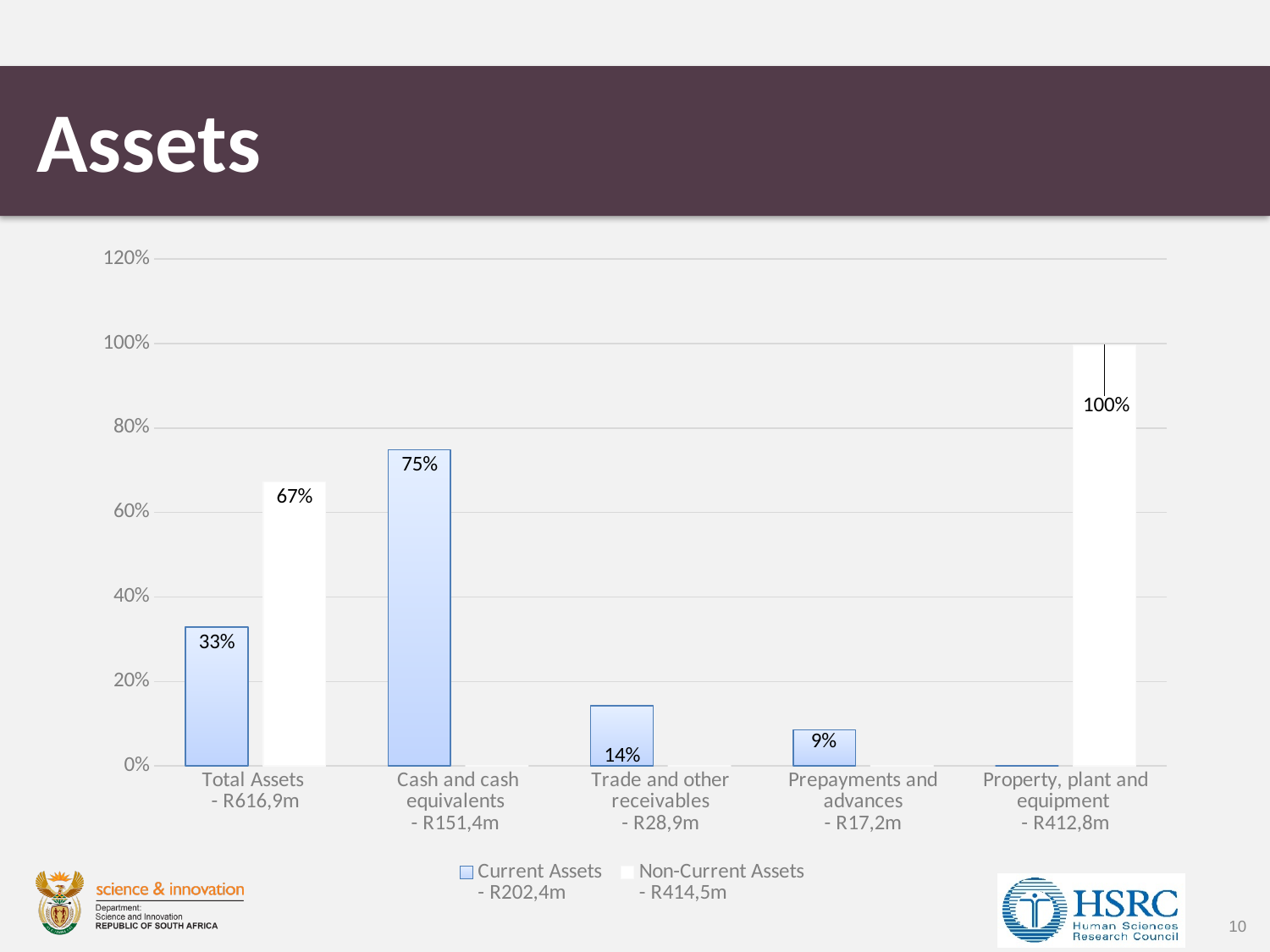
What is the Current Assets value for Total Assets? 33% How many series does the legend list? 2 What is the Current Assets value for Trade and other receivables? 14% What is the Non-Current Assets value for Total Assets? 67% What is the Current Assets value for Cash and cash equivalents? 75% Which category has the lowest labelled Current Assets value? Prepayments and advances Which category has the highest Current Assets value? Cash and cash equivalents What is the Non-Current Assets value for Property, plant and equipment? 100% Which is larger for Total Assets: the Current Assets value or the Non-Current Assets value? Non-Current Assets What is the difference between the Current Assets values for Cash and cash equivalents and Trade and other receivables? 61% How many categories are shown on the x axis? 5 What type of chart is shown on the slide? Bar chart